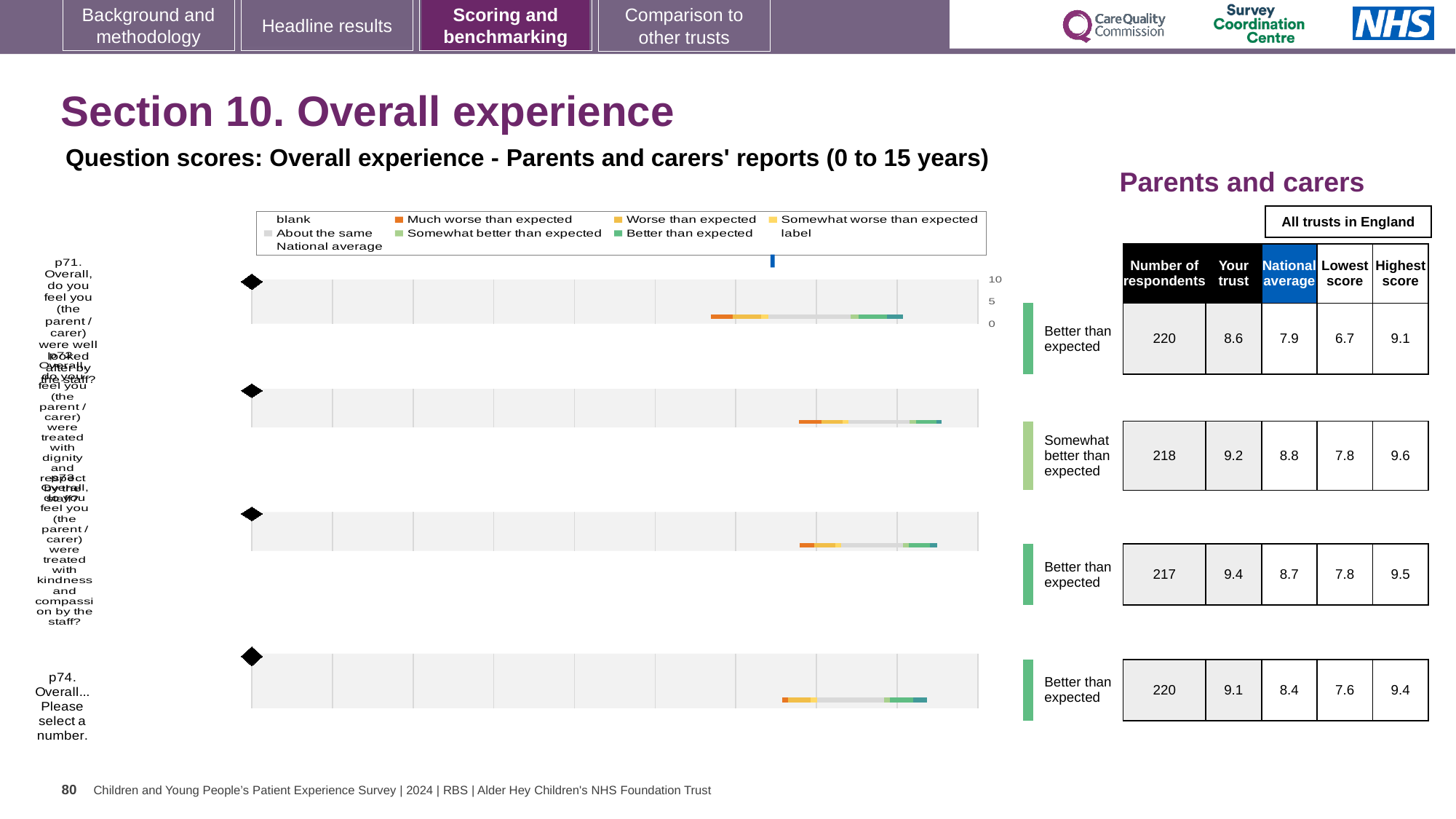
What is the title of the chart on this slide? Question scores: Overall experience - Parents and carers' reports (0 to 15 years) In the table, is the 'Your trust' score for p74 larger or smaller than its national average? larger In the table, which row has the highest 'Your trust' score? the third row (9.4) In the table, what is the difference between the 'Your trust' score and the national average for question p71? 0.7 In the chart legend, which colour represents 'Much worse than expected'? orange In the table, what is the national average for question p74? 8.4 In the table, how many respondents answered question p71? 220 What kind of chart is used to show the question scores on this slide? bar chart In the table, what is the highest score for the second row (Somewhat better than expected)? 9.6 In the table, which question has the lowest 'Your trust' score? p71 (8.6) In the table, what is the 'Your trust' score for question p71? 8.6 How many question rows (bars) are plotted in the question scores chart? 4